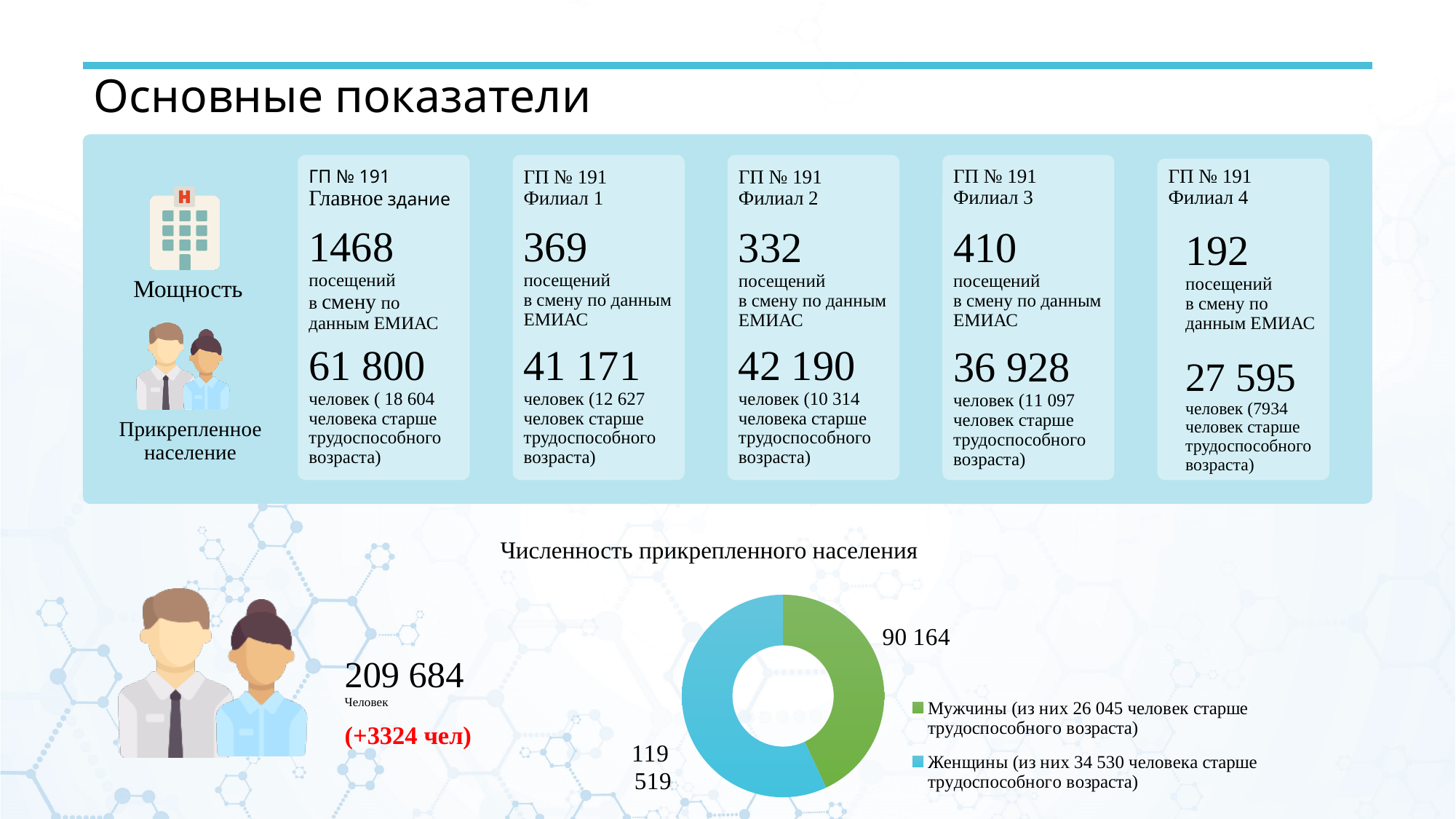
What is the title of the chart at the bottom of the slide? Численность прикрепленного населения In the chart "Численность прикрепленного населения", which category has the larger value? Женщины In the chart "Численность прикрепленного населения", what colour is the Мужчины slice? green In the chart "Численность прикрепленного населения", what is the value for Мужчины? 90 164 In the chart "Численность прикрепленного населения", which category has the smaller value? Мужчины How many slices does the chart "Численность прикрепленного населения" have? 2 In the chart "Численность прикрепленного населения", what is the difference between the values for Женщины and Мужчины? 29 355 In the chart "Численность прикрепленного населения", what is the value for Женщины? 119 519 What kind of chart is shown under the title "Численность прикрепленного населения"? doughnut (pie) chart In the chart "Численность прикрепленного населения", is the value for Женщины larger or smaller than the value for Мужчины? larger How many entries does the legend of the chart "Численность прикрепленного населения" list? 2